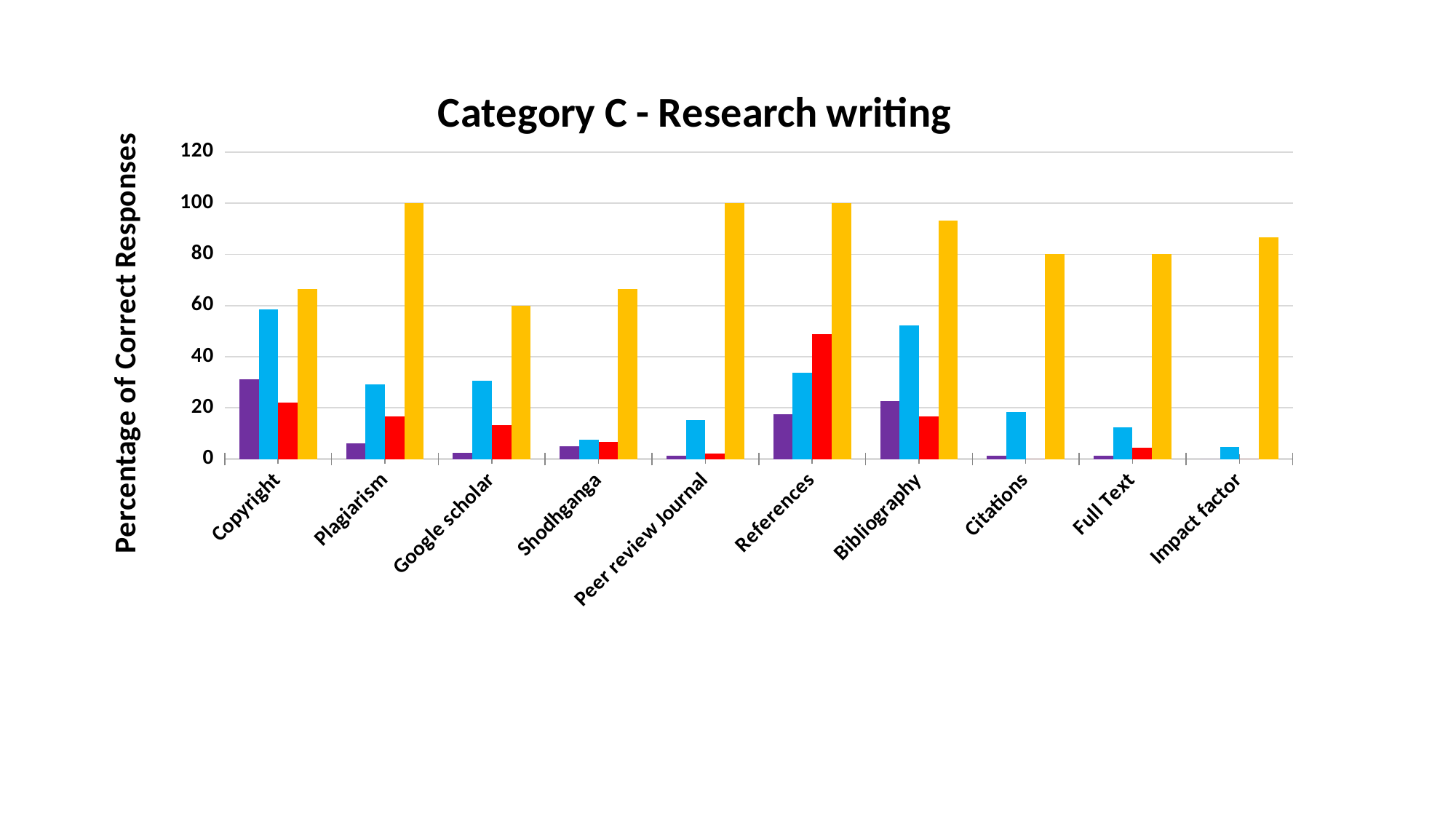
What type of chart is shown on the slide? bar chart Which category has the highest purple bar? Copyright What is the value of the yellow bar for Plagiarism? 100 What is the title of the chart? Category C - Research writing How many bars are plotted for each category in the chart? 4 Which category has the lowest yellow bar? Google scholar Is the red bar for References larger or smaller than the red bar for Copyright? larger What is the label on the vertical axis of the chart? Percentage of Correct Responses How many categories are shown along the x axis of the chart? 10 What is the value of the yellow bar for Google scholar? 60 Which category has the highest red bar? References Is the value of the blue bar for Copyright greater or less than 40? greater